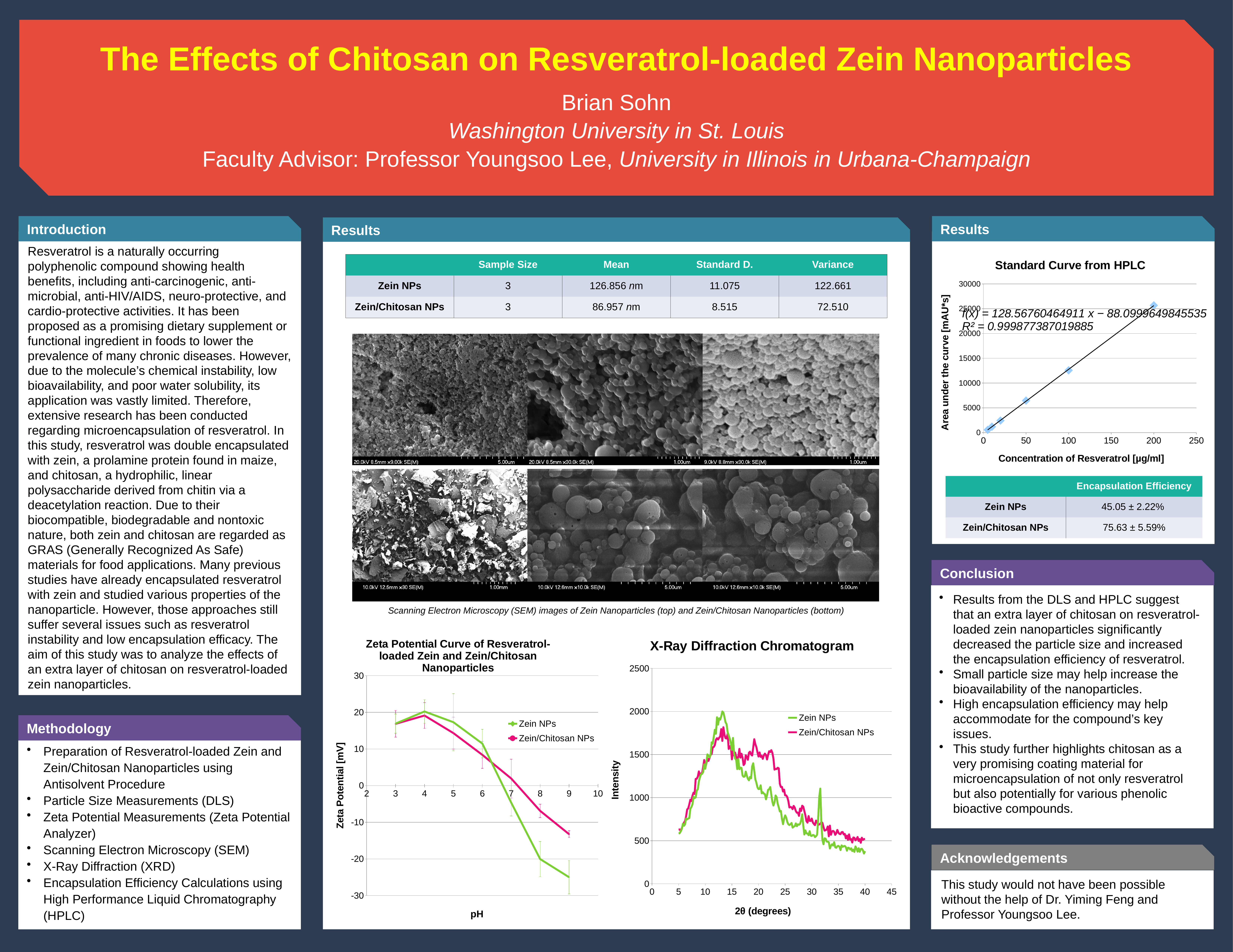
In the 'X-Ray Diffraction Chromatogram' chart, is the peak intensity of Zein NPs greater or less than 1500? greater What is the label of the x axis of the 'Zeta Potential Curve' chart? pH In the 'Zeta Potential Curve' chart, which series has the larger zeta potential at pH 9? Zein/Chitosan NPs In the 'Zeta Potential Curve' chart, is the value for Zein NPs at pH 9 greater or less than -20? less What kind of chart is the 'Zeta Potential Curve of Resveratrol-loaded Zein and Zein/Chitosan Nanoparticles'? line chart In the 'Standard Curve from HPLC' chart, is the area under the curve at a concentration of 200 µg/ml greater or less than 20000? greater In the 'X-Ray Diffraction Chromatogram' chart, which series reaches the higher peak intensity? Zein NPs In the 'Zeta Potential Curve' chart, do the zeta potential values rise or fall as pH increases from 4 to 9? fall What is the R² value shown on the 'Standard Curve from HPLC' chart? 0.999877387019885 In the 'Standard Curve from HPLC' chart, does the area under the curve rise or fall as concentration increases? rise How many series does the legend of the 'X-Ray Diffraction Chromatogram' chart list? 2